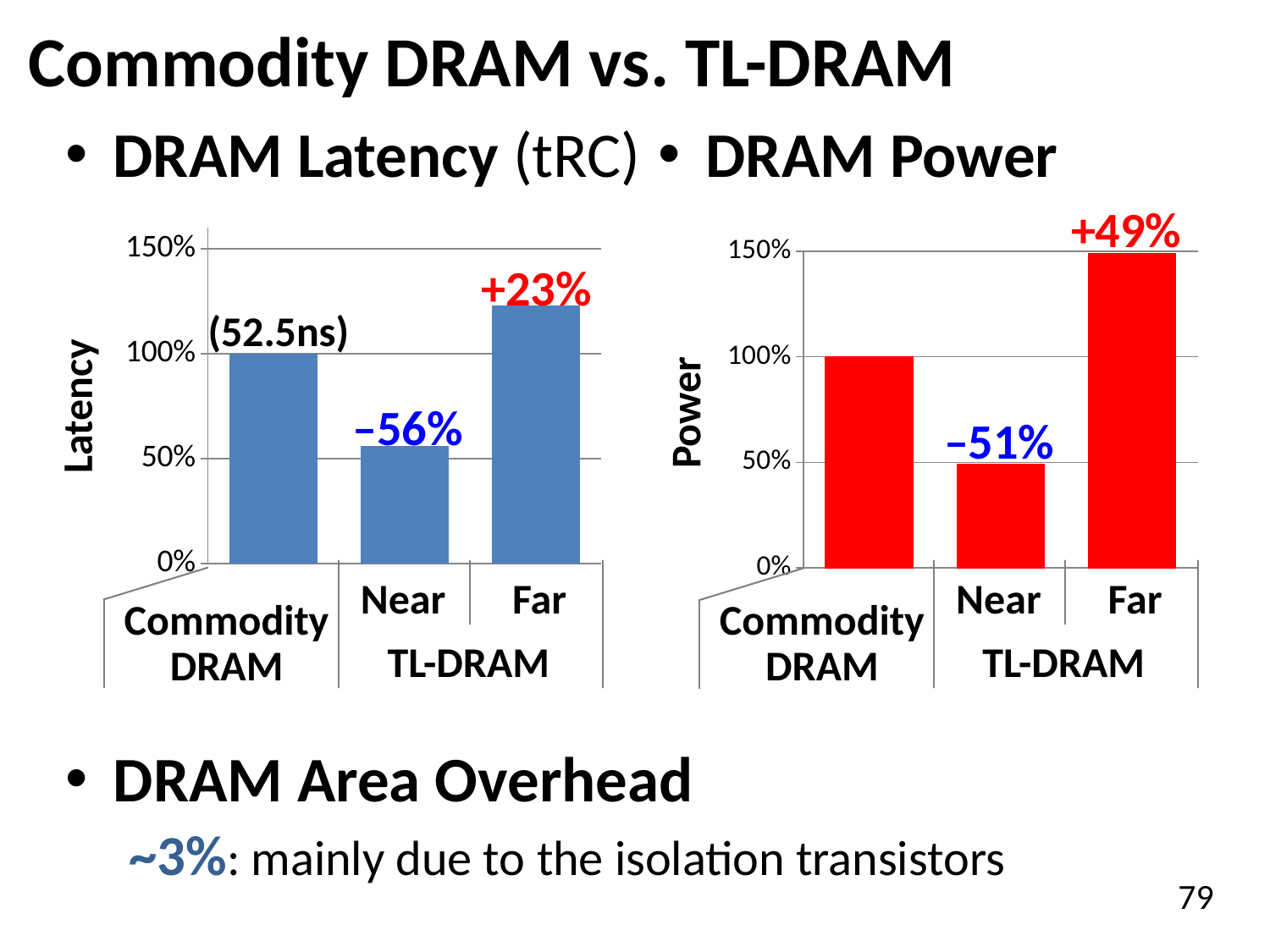
In the DRAM Power chart, what change label is printed above the TL-DRAM Near bar? –51% In the DRAM Latency chart, what value does the Commodity DRAM bar reach? 100% How many bars are plotted in the DRAM Power chart? 3 In the DRAM Power chart, which bar is the highest? Far (TL-DRAM) In the DRAM Power chart, what change label is printed above the TL-DRAM Far bar? +49% In the DRAM Latency chart, what change label is printed above the TL-DRAM Far bar? +23% In the DRAM Power chart, is the value for TL-DRAM Far greater or less than 100%? greater What kind of chart is the DRAM Latency chart? bar chart In the DRAM Latency chart, what change label is printed above the TL-DRAM Near bar? –56% In the DRAM Latency chart, what absolute latency is noted above the Commodity DRAM bar? (52.5ns) In the DRAM Latency chart, which bar is the lowest? Near (TL-DRAM) In the DRAM Latency chart, is the value for TL-DRAM Near greater or less than 50%? greater